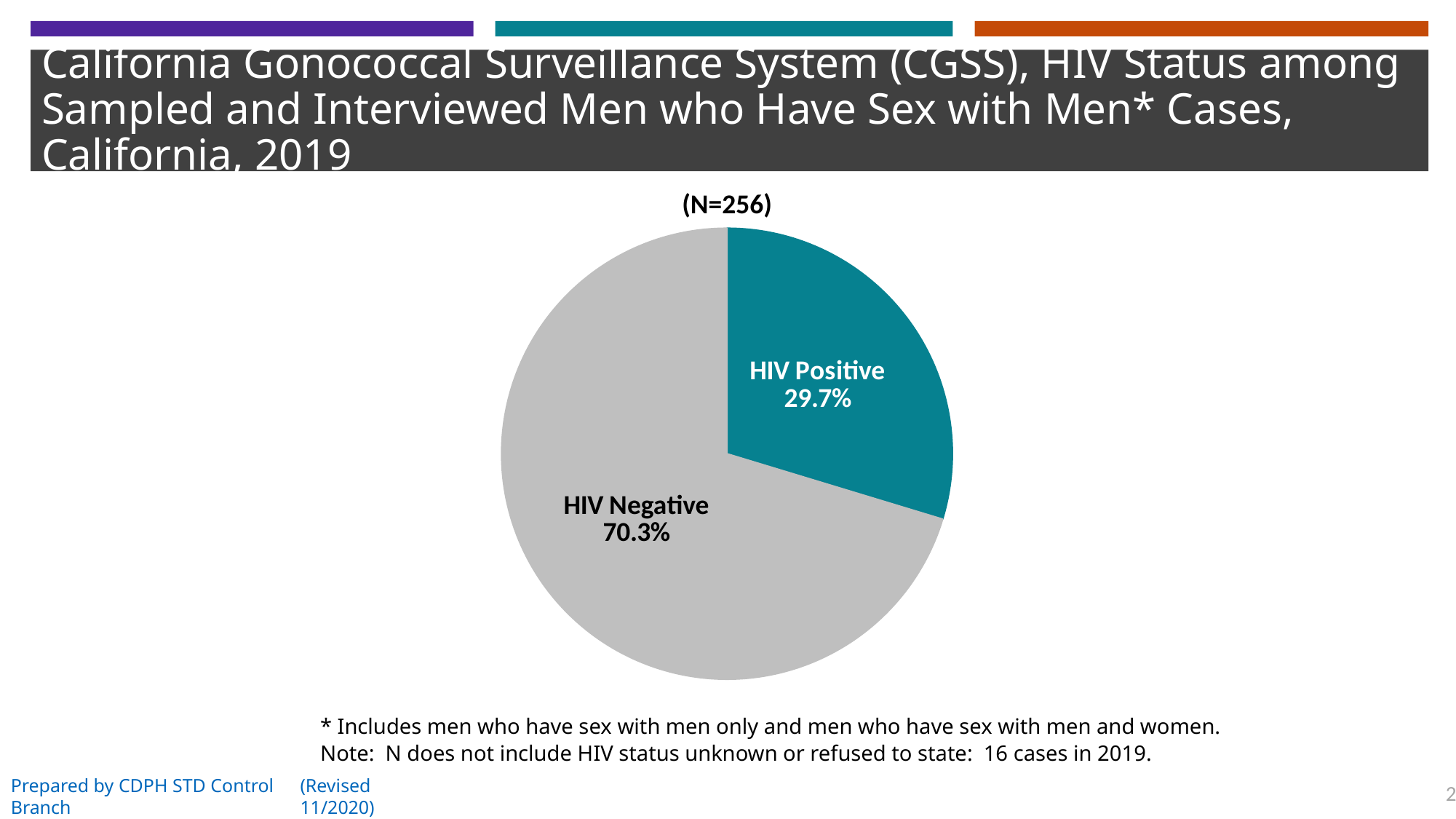
What kind of chart is shown on the slide? Pie chart What is the total number of cases (N) shown above the pie chart? 256 What colour is the HIV Positive slice? Teal Which HIV status category has the largest share of the pie? HIV Negative Which is larger, the HIV Positive slice or the HIV Negative slice? HIV Negative What share of the pie does the HIV Positive slice represent? 29.7% Which HIV status category has the smallest share of the pie? HIV Positive What percentage of cases are HIV Positive? 29.7% How many slices does the pie chart have? 2 What is the difference in percentage points between the HIV Negative and HIV Positive slices? 40.6 What percentage of cases are HIV Negative? 70.3%